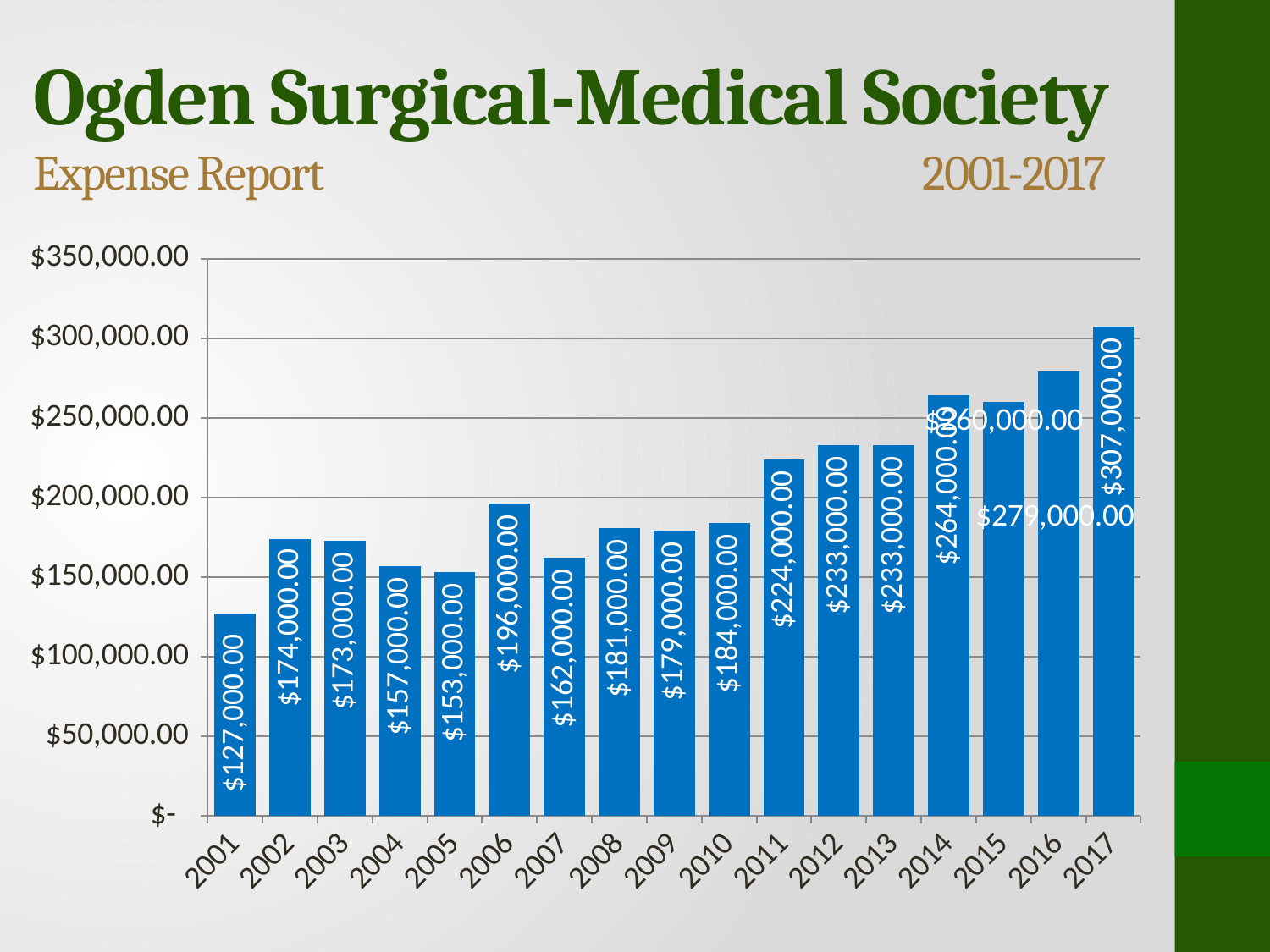
What is the difference between the expenses in 2017 and 2001? $180,000.00 Which year had the highest expenses? 2017 How many years are shown on the chart? 17 Is the value for 2014 greater or less than $250,000.00? greater Which year had the lowest expenses? 2001 What was the expense value for 2017? $307,000.00 Do expenses generally rise or fall from 2001 to 2017? rise Which year had higher expenses, 2006 or 2010? 2006 What is the highest value shown on the y axis? $350,000.00 What was the expense value for 2011? $224,000.00 What was the expense value for 2001? $127,000.00 What kind of chart is shown on the slide? bar chart